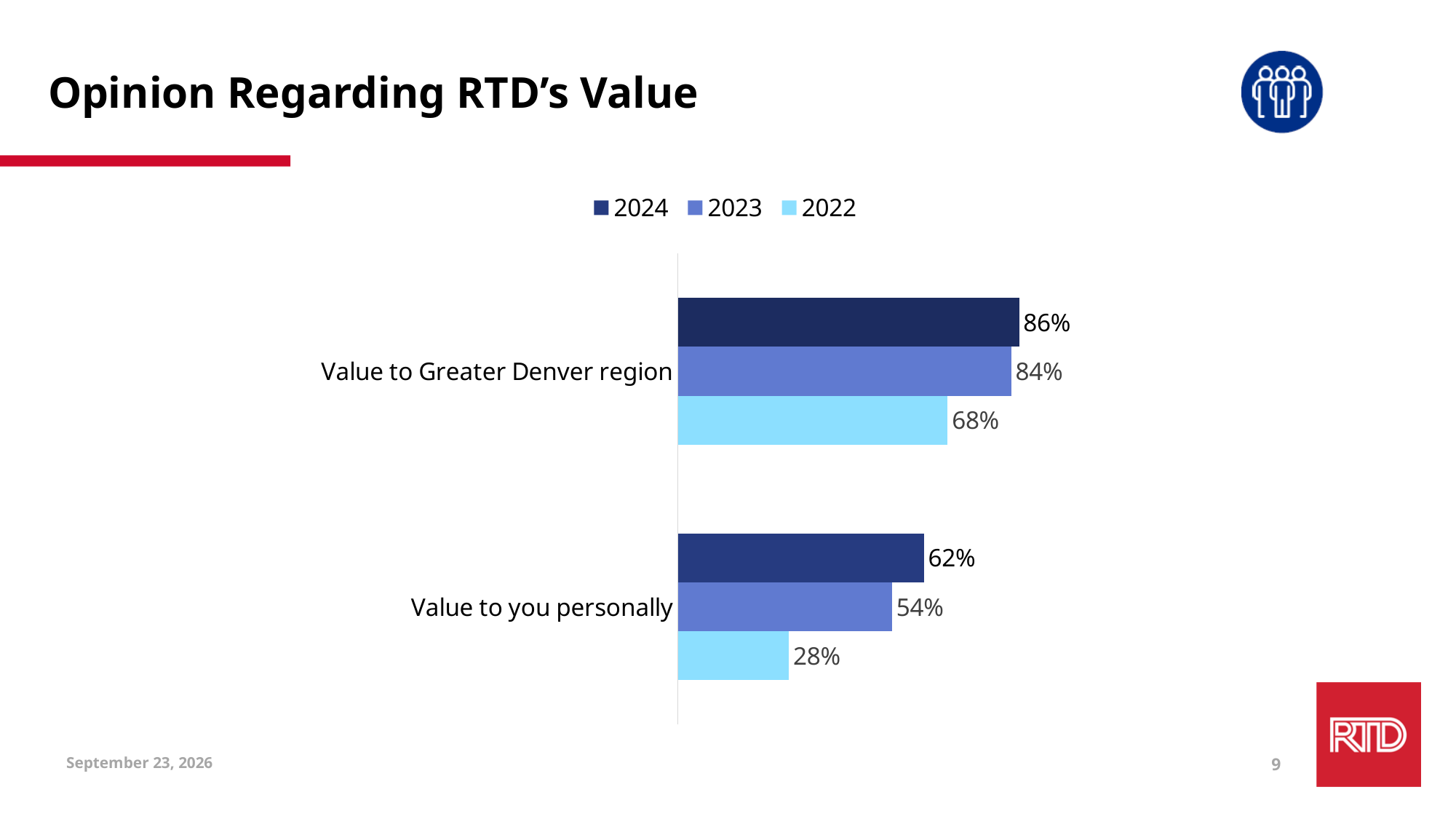
What is the 2024 value for Value to Greater Denver region? 86% What is the 2024 value for Value to you personally? 62% What is the 2023 value for Value to Greater Denver region? 84% Which year has the highest value for Value to you personally? 2024 What is the difference between the 2024 and 2023 values for Value to Greater Denver region? 2% What is the 2022 value for Value to you personally? 28% What kind of chart is shown on the slide? Bar chart How many series does the legend list? 3 Which is larger: the 2023 value for Value to Greater Denver region or the 2023 value for Value to you personally? Value to Greater Denver region What is the difference between the 2024 and 2022 values for Value to you personally? 34% How many categories are shown on the chart? 2 Which year has the lowest value for Value to Greater Denver region? 2022